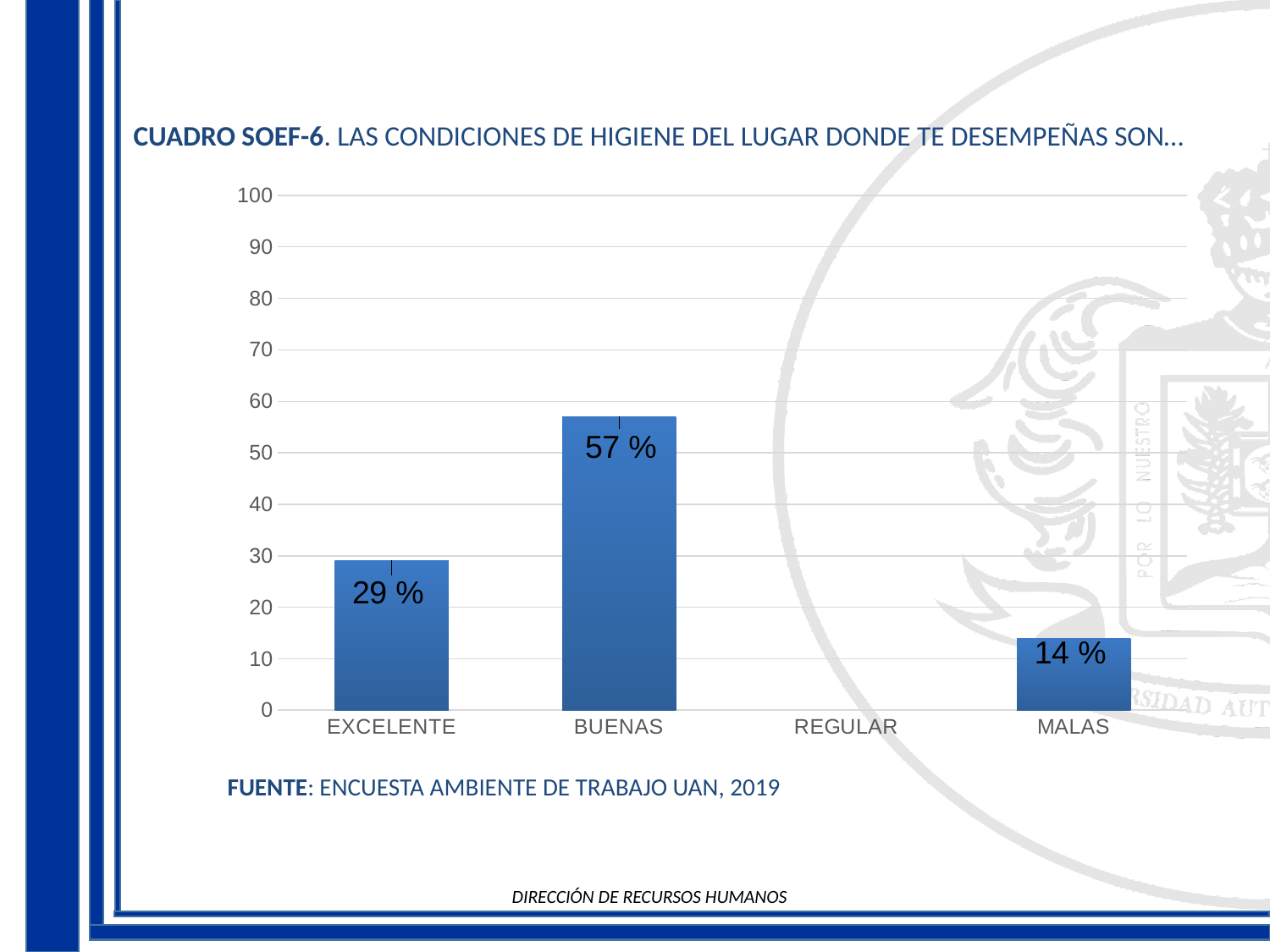
What kind of chart is shown on the slide? bar chart What is the value for MALAS? 14 % What is the difference between the values for BUENAS and EXCELENTE? 28 % What is the source cited below the chart? ENCUESTA AMBIENTE DE TRABAJO UAN, 2019 Which is larger, the value for EXCELENTE or the value for MALAS? EXCELENTE Which category has the highest value? BUENAS How many categories are shown on the x axis? 4 What is the value for BUENAS? 57 % Is the value for BUENAS greater or less than 50? greater What is the difference between the values for EXCELENTE and MALAS? 15 % What is the value for EXCELENTE? 29 % Which category with a visible bar has the lowest value? MALAS